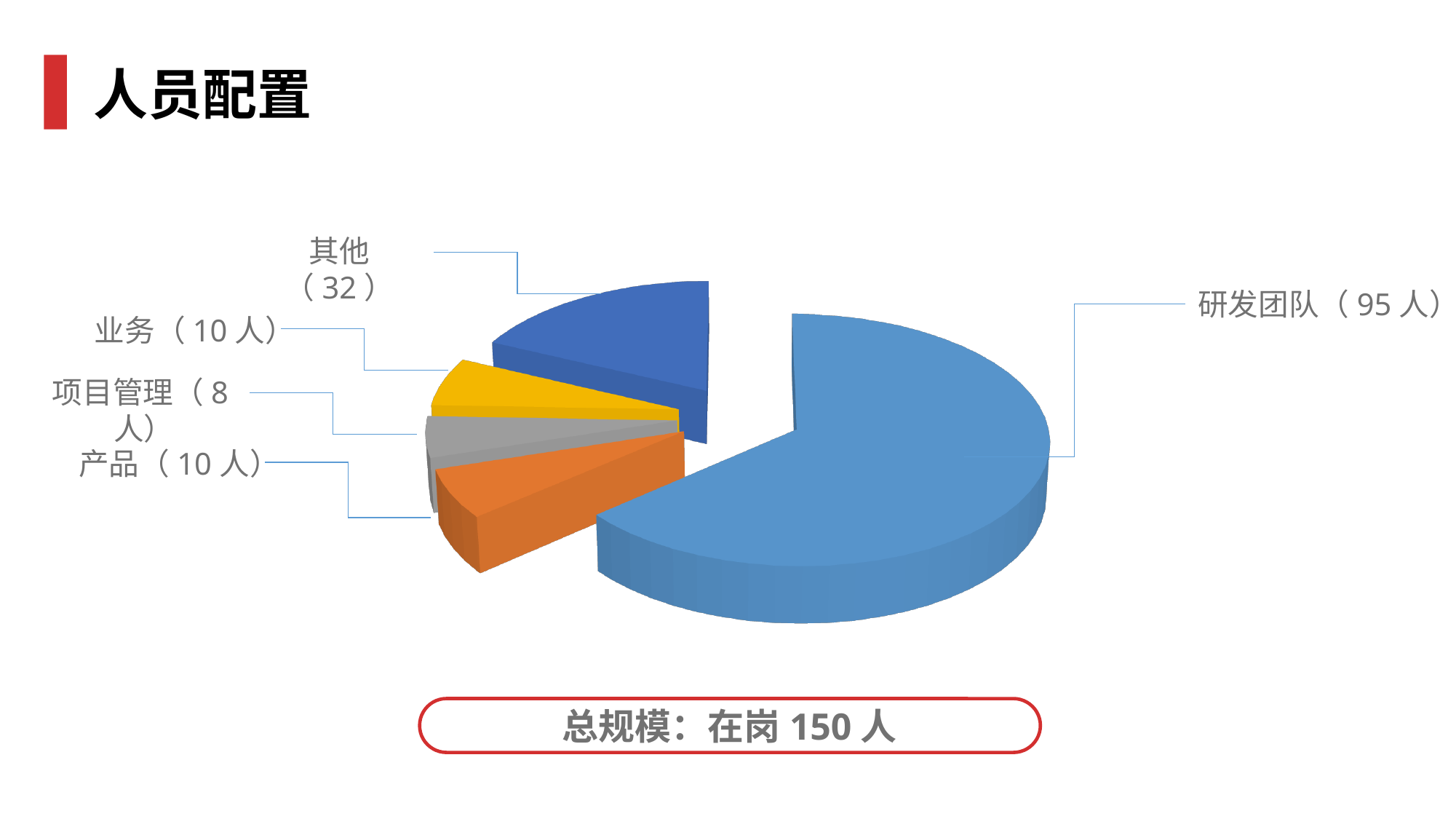
What kind of chart is shown on the slide? pie chart How many categories are shown in the pie chart? 5 What is the value for 产品 in the pie chart? 10 人 Which category has the smallest slice in the pie chart? 项目管理 What is the difference between the values for 研发团队 and 其他? 63 How many people are in 项目管理 according to the pie chart? 8 人 Which category has the largest slice in the pie chart? 研发团队 What is the title of the slide? 人员配置 What is the value for 研发团队 in the pie chart? 95 人 What is the value shown for 其他 in the pie chart? 32 What is the difference between the values for 业务 and 项目管理? 2 Which is larger, the value for 其他 or the value for 业务? 其他